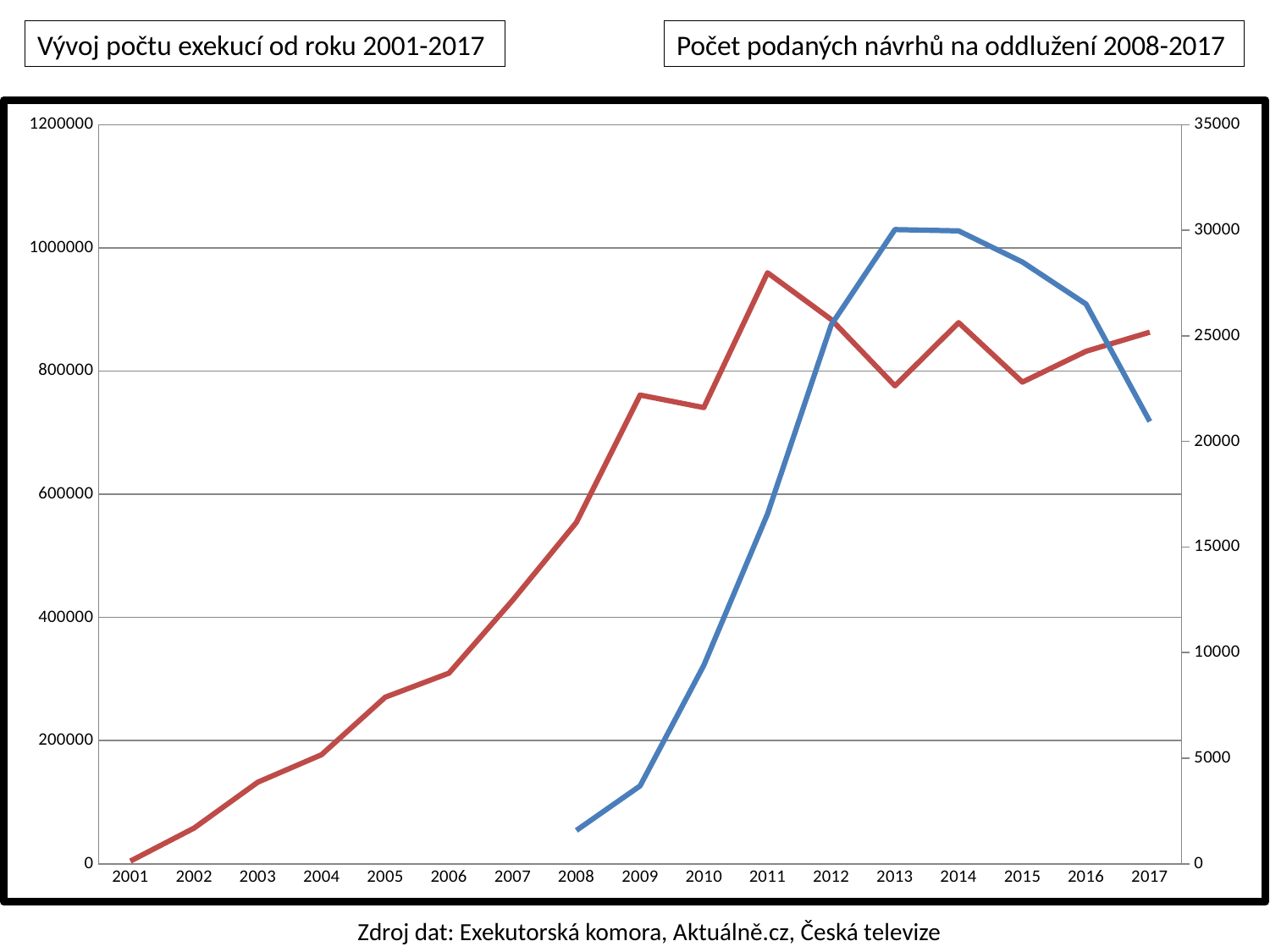
Does the red line (number of executions) rise or fall between 2001 and 2011? rise In which year does the red line (number of executions) reach its highest value? 2011 How many years are shown on the x axis? 17 Is the value of the blue line (debt relief proposals) in 2008 greater or less than 5000 on the right axis? less Is the value of the blue line (debt relief proposals) in 2013 greater or less than 25000 on the right axis? greater Which year has the higher value on the blue line (debt relief proposals), 2016 or 2017? 2016 What kind of chart is shown on the slide? line chart Is the value of the red line (number of executions) in 2011 greater or less than 800000 on the left axis? greater What data sources are cited below the chart? Exekutorská komora, Aktuálně.cz, Česká televize In which year does the red line (number of executions) have its lowest value? 2001 In which year does the blue line (debt relief proposals) have its lowest value? 2008